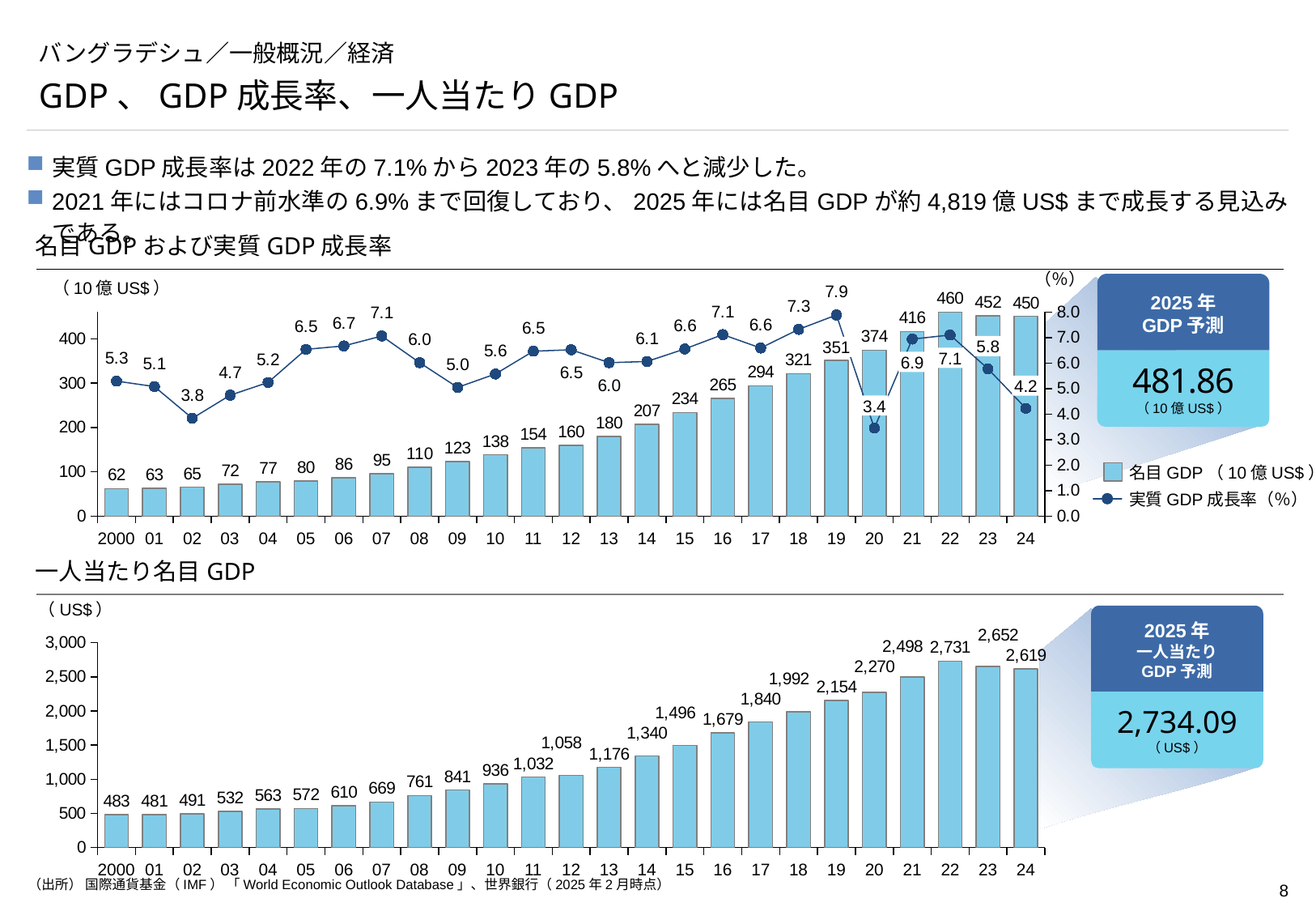
In the chart titled 一人当たり名目GDP, which year has the lowest value? 01 In the chart titled 一人当たり名目GDP, what is the difference between the values for 2023 and 2024? 33 In the chart titled 名目GDPおよび実質GDP成長率, what is the real GDP growth rate for 2020? 3.4 In the chart titled 名目GDPおよび実質GDP成長率, what is the 2025 GDP forecast shown in the box on the right? 481.86 In the chart titled 名目GDPおよび実質GDP成長率, how many series does the legend list? 2 In the chart titled 一人当たり名目GDP, which year has the highest value? 22 In the chart titled 名目GDPおよび実質GDP成長率, what is the difference in nominal GDP between 2024 and 2000? 388 What type of chart is the chart titled 一人当たり名目GDP? Bar chart In the chart titled 一人当たり名目GDP, how many years are plotted? 25 In the chart titled 名目GDPおよび実質GDP成長率, what is the nominal GDP value for 2022? 460 In the chart titled 名目GDPおよび実質GDP成長率, which year has the highest real GDP growth rate? 19 In the chart titled 一人当たり名目GDP, what is the value for 2019? 2,154